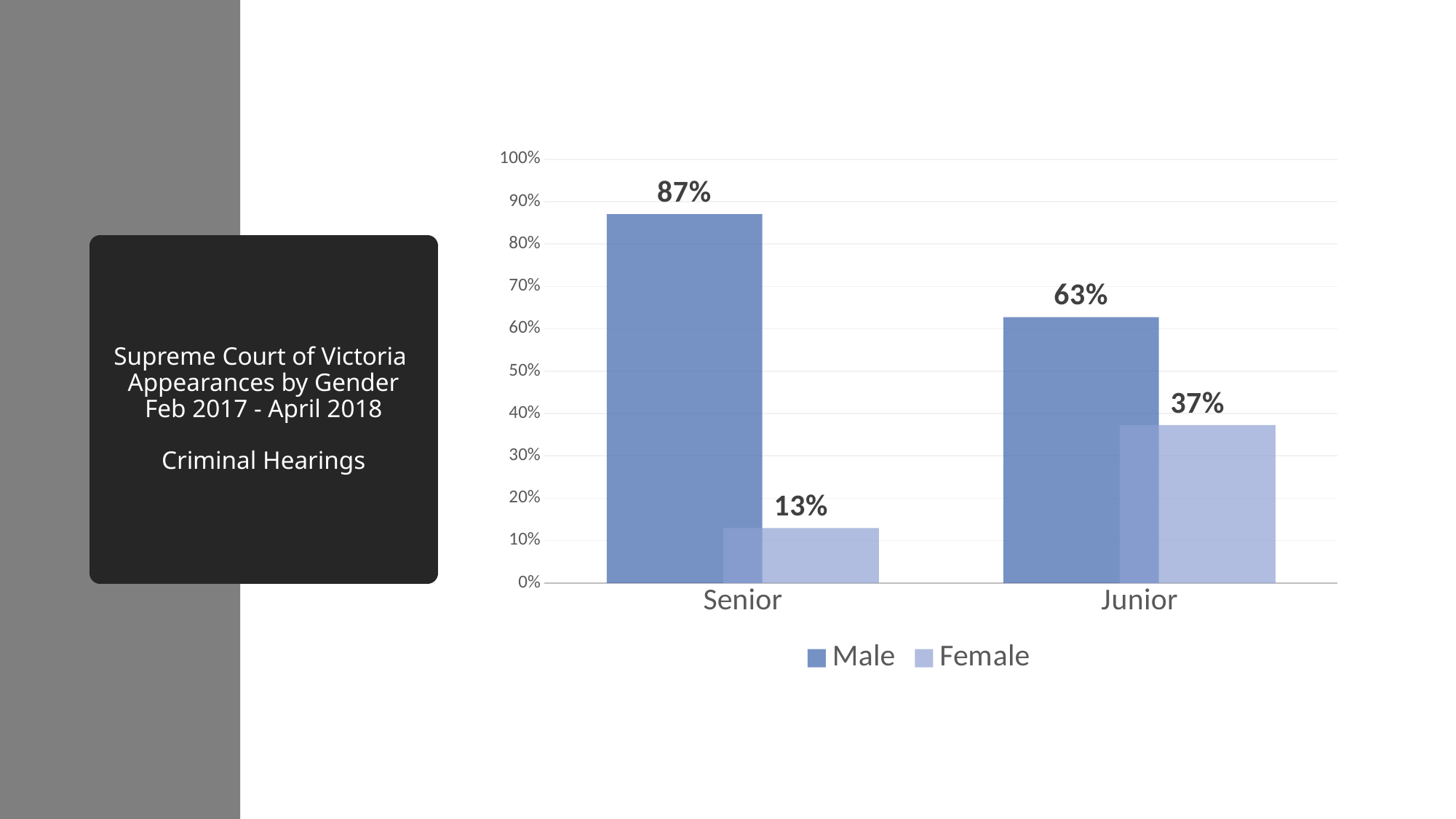
What percentage of Senior appearances were Male? 87% What percentage of Junior appearances were Female? 37% What percentage of Senior appearances were Female? 13% What percentage of Junior appearances were Male? 63% What is the difference between the Male percentages for Senior and Junior appearances? 24% What is the difference between the Male and Female percentages for Senior appearances? 74% What kind of chart is shown on the slide? Bar chart Which is larger: the Female percentage for Junior or the Female percentage for Senior? Junior How many series does the legend list? 2 How many categories are shown on the x axis? 2 Which category has the highest Male percentage? Senior Which category has the lowest Female percentage? Senior